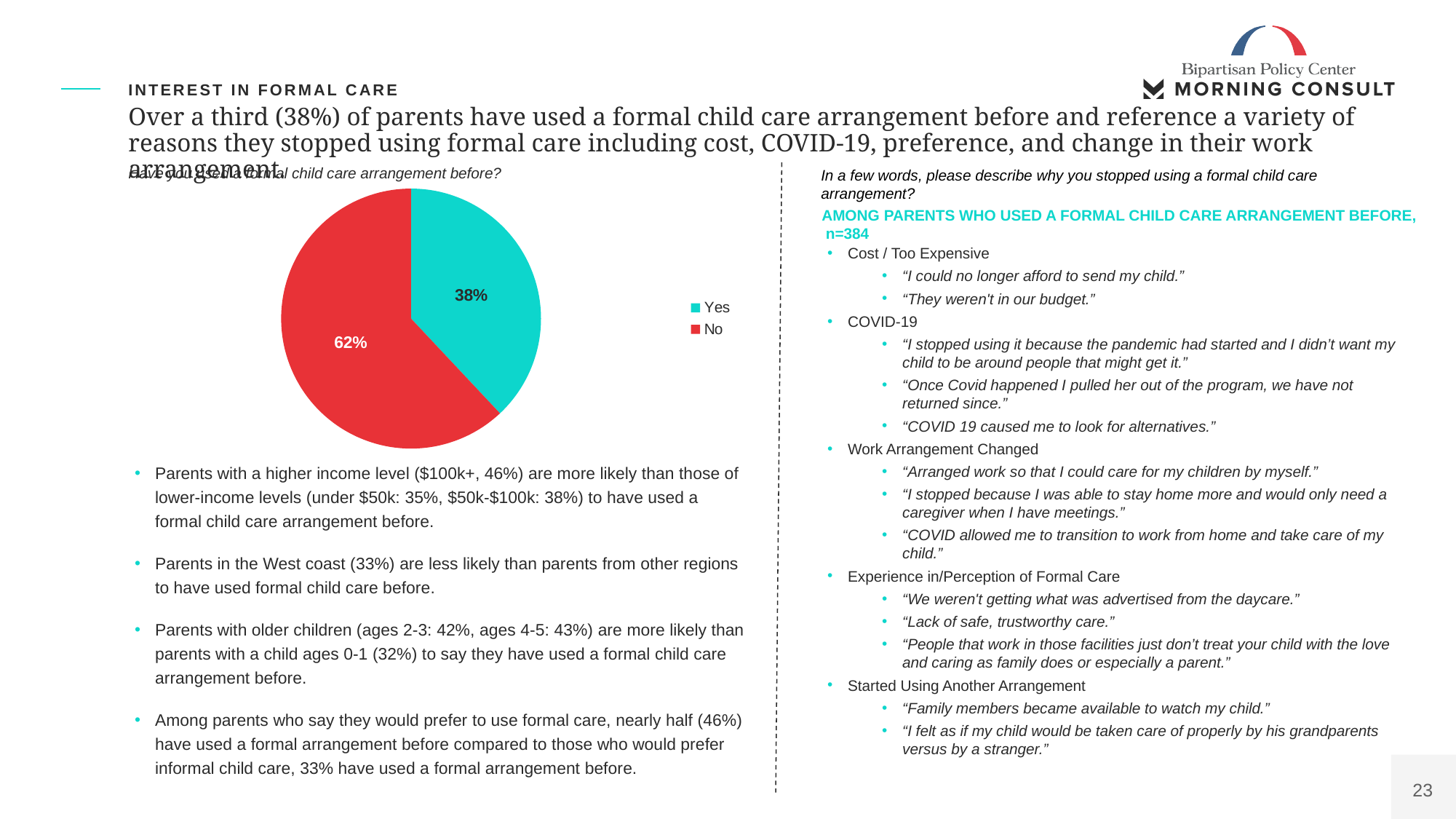
How many slices does the pie chart have? 2 What kind of chart is shown on the slide? Pie chart What percentage of parents answered "No" to having used a formal child care arrangement before? 62% What percentage of parents answered "Yes" to having used a formal child care arrangement before? 38% Which response has the larger share of the pie, Yes or No? No Is the share for No greater or less than 50%? greater What colour is the "Yes" slice of the pie chart? Teal How many entries does the legend list? 2 What is the difference in percentage points between the No and Yes slices? 24 percentage points What colour is the "No" slice of the pie chart? Red Which response has the smaller share of the pie? Yes Is the share for Yes larger or smaller than the share for No? Smaller